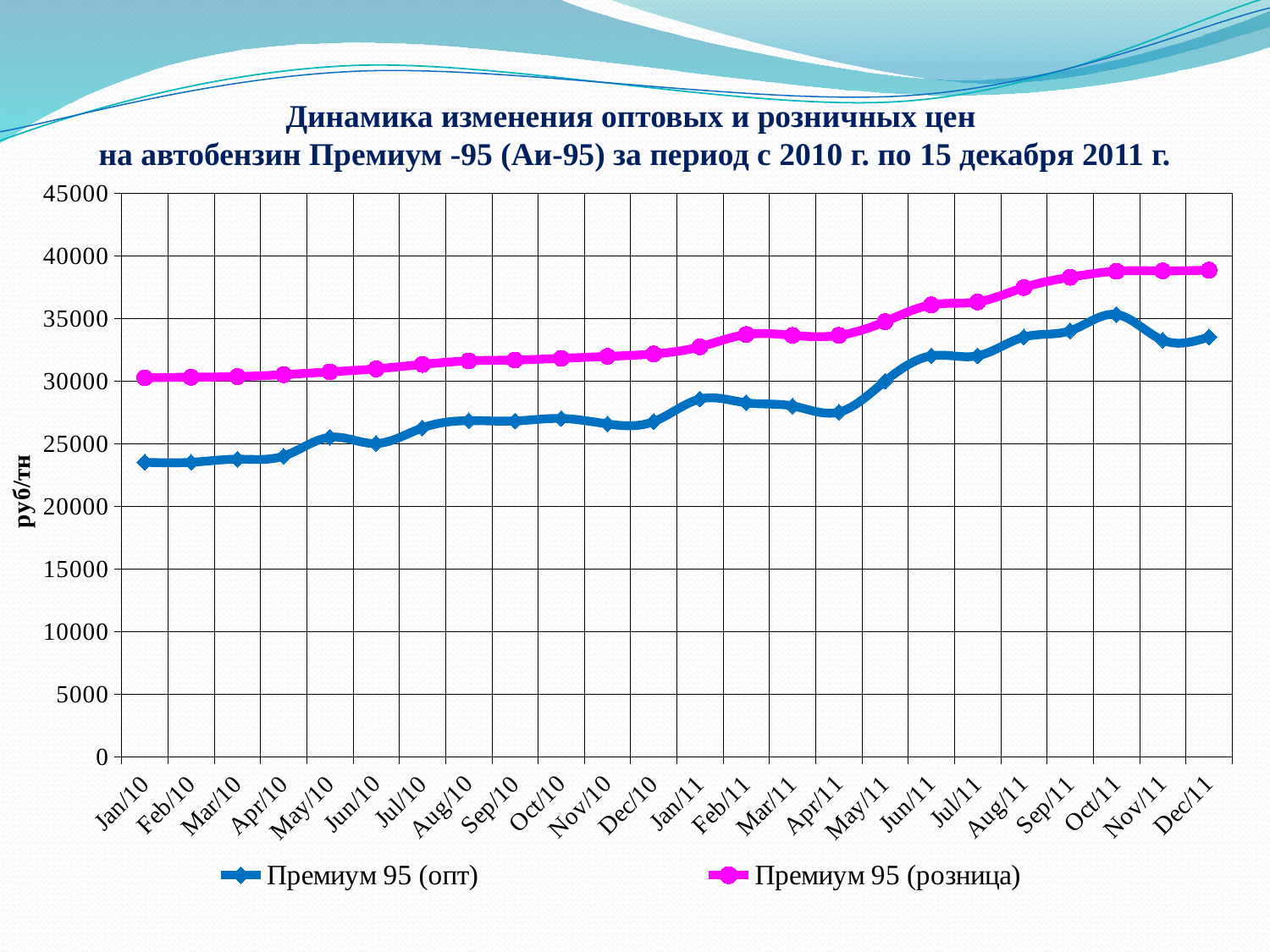
Which series is plotted in magenta? Премиум 95 (розница) Is the value for Премиум 95 (розница) in Jan/10 greater or less than 25000? greater In Dec/11, which series has the larger value, Премиум 95 (опт) or Премиум 95 (розница)? Премиум 95 (розница) Is the value for Премиум 95 (опт) in Jan/10 greater or less than 25000? less Is the value for Премиум 95 (розница) in Dec/11 greater or less than 35000? greater What kind of chart is shown on the slide? line chart Do the values for Премиум 95 (розница) generally rise or fall from Jan/10 to Dec/11? rise How many series does the legend list? 2 How many monthly points are plotted along the x axis? 24 What is the label on the vertical axis? руб/тн In which month does Премиум 95 (опт) reach its highest value? Oct/11